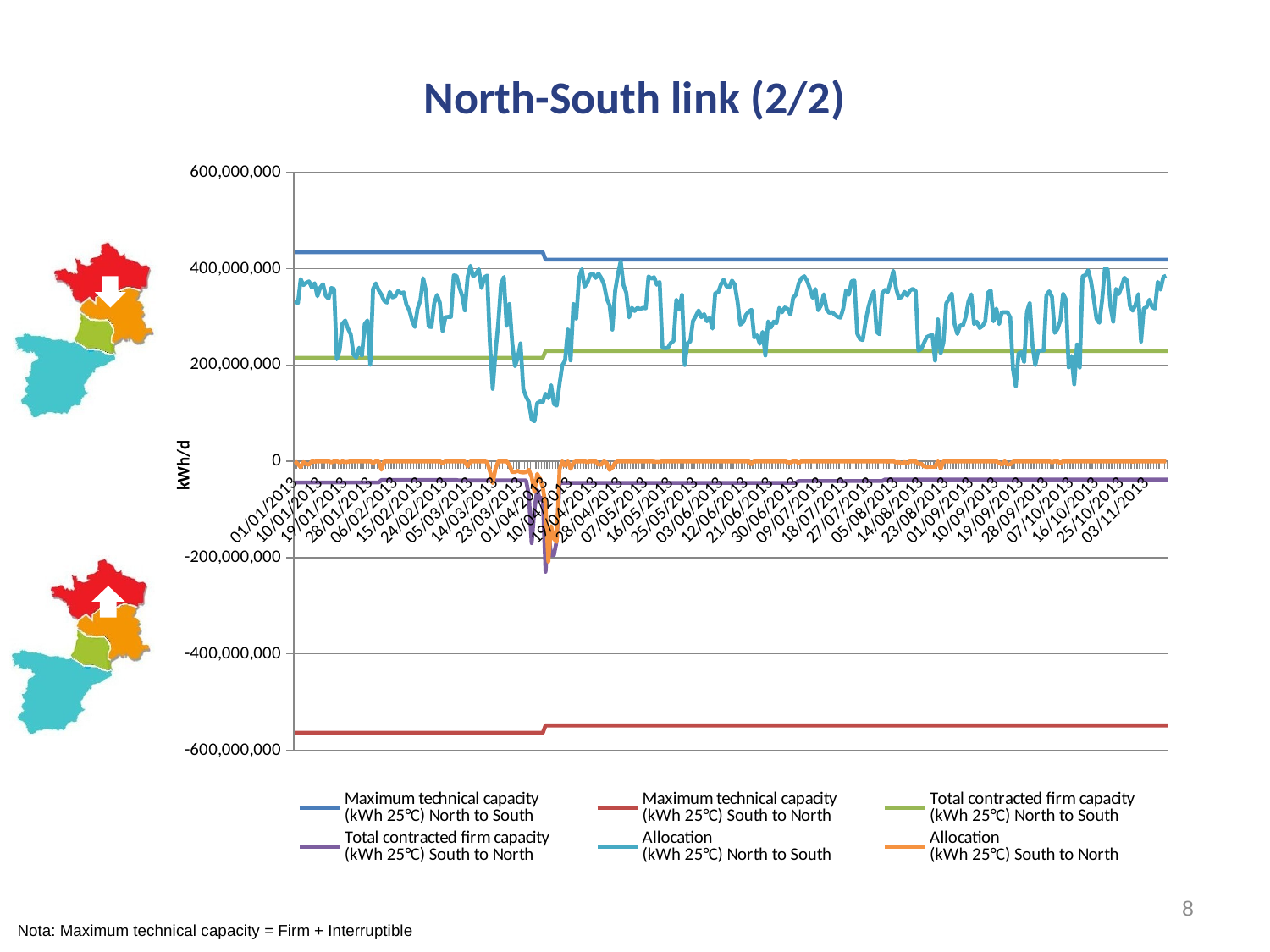
Is the value of the Total contracted firm capacity (kWh 25°C) South to North line greater or less than -200,000,000 for most of the period? greater Does the Maximum technical capacity (kWh 25°C) North to South line step up or down around April 2013? down How many series does the chart legend list? 6 Does the Total contracted firm capacity (kWh 25°C) North to South line step up or down around April 2013? up Is the value of the Maximum technical capacity (kWh 25°C) North to South line greater or less than 400,000,000 throughout the period? greater Is the value of the Total contracted firm capacity (kWh 25°C) North to South line greater or less than 200,000,000? greater What is the highest value shown on the vertical axis of the chart? 600,000,000 What kind of chart is shown on the slide? line chart Which series is larger for the whole period: Maximum technical capacity (kWh 25°C) North to South or Total contracted firm capacity (kWh 25°C) North to South? Maximum technical capacity (kWh 25°C) North to South What is the title of the slide containing the chart? North-South link (2/2) What is the label on the vertical axis of the chart? kWh/d